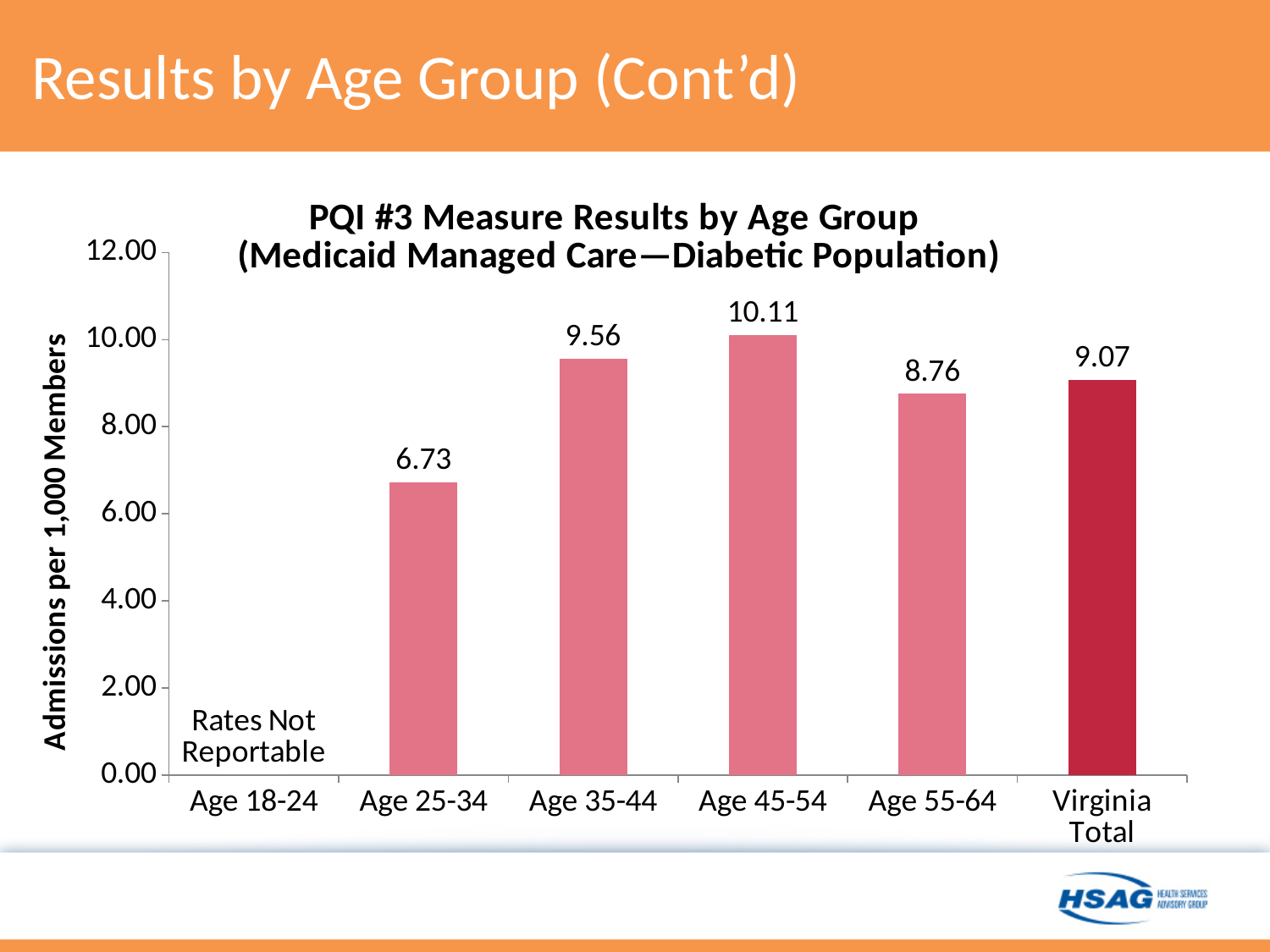
What is the label of the y axis? Admissions per 1,000 Members What is the value for Age 25-34? 6.73 Is the value for Age 55-64 greater or less than 8.00? greater How many categories are shown on the x axis? 6 Which is larger, the value for Age 35-44 or the value for Virginia Total? Age 35-44 What kind of chart is shown on the slide? bar chart What is the value for Age 45-54? 10.11 Which age group has the highest admissions per 1,000 members? Age 45-54 What is shown for the Age 18-24 category? Rates Not Reportable Among the age groups with reported rates, which has the lowest value? Age 25-34 What is the value for Virginia Total? 9.07 What is the difference between the values for Age 45-54 and Age 55-64? 1.35